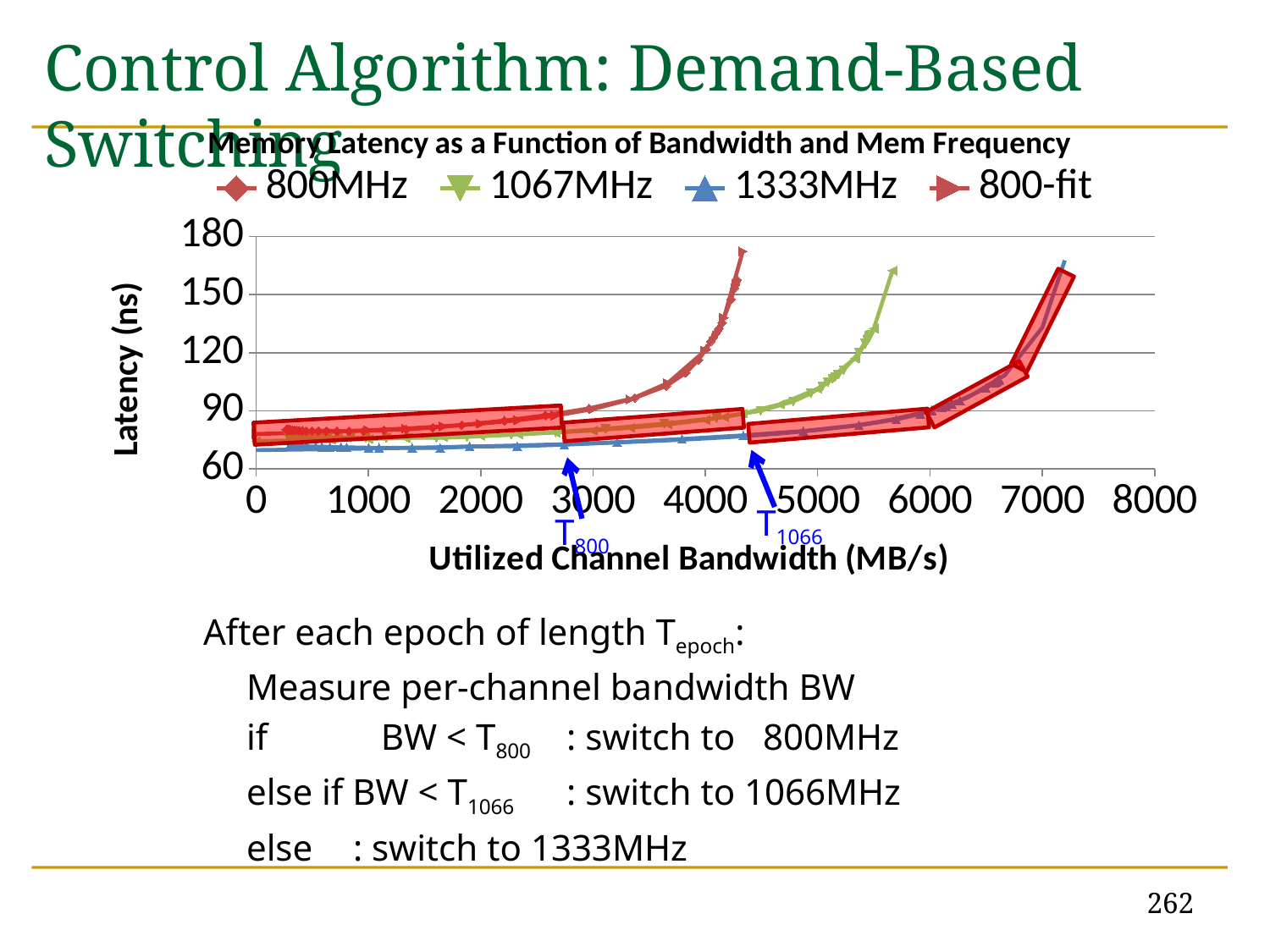
Does latency rise or fall as utilized channel bandwidth increases along the x axis? rise Is the latency of the 1333MHz series at 0 MB/s bandwidth greater or less than 90 ns? less Which series extends to the highest utilized channel bandwidth on the chart? 1333MHz What is the title of the chart? Memory Latency as a Function of Bandwidth and Mem Frequency Is the highest latency reached by the 1067MHz series greater or less than 150 ns? greater How many series does the chart legend list? 4 Is the latency of the 800MHz series at 1000 MB/s bandwidth greater or less than 90 ns? less What is the highest value shown on the y axis of the chart? 180 At 2000 MB/s bandwidth, which series has the higher latency, 800MHz or 1333MHz? 800MHz What kind of chart is shown on the slide? line chart Which series has its latency rise steeply at the lowest bandwidth? 800MHz What is the label of the chart's y axis? Latency (ns)